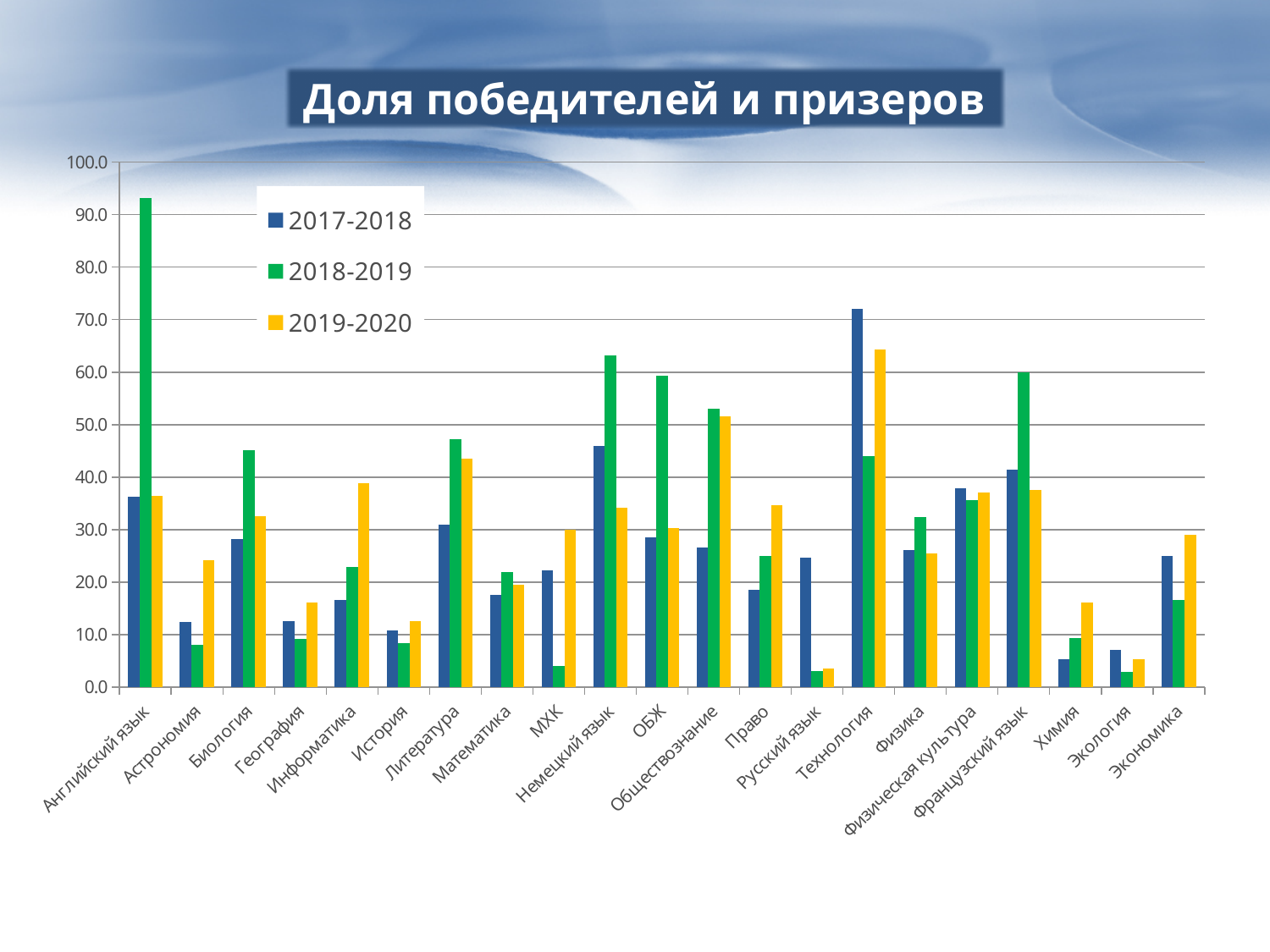
How many series does the legend list? 3 What kind of chart is shown on the slide? Bar chart Which subject has the highest value for the 2018-2019 series? Английский язык Which subject has the highest value for the 2019-2020 series? Технология Is the 2018-2019 value for Английский язык greater or less than 90? greater What is the title of the chart? Доля победителей и призеров Which subject has the highest value for the 2017-2018 series? Технология For Технология, which series has the larger value: 2017-2018 or 2018-2019? 2017-2018 How many subject categories are shown on the x axis? 21 Is the 2019-2020 value for Право greater or less than 30? greater Is the 2017-2018 value for Технология greater or less than 70? greater